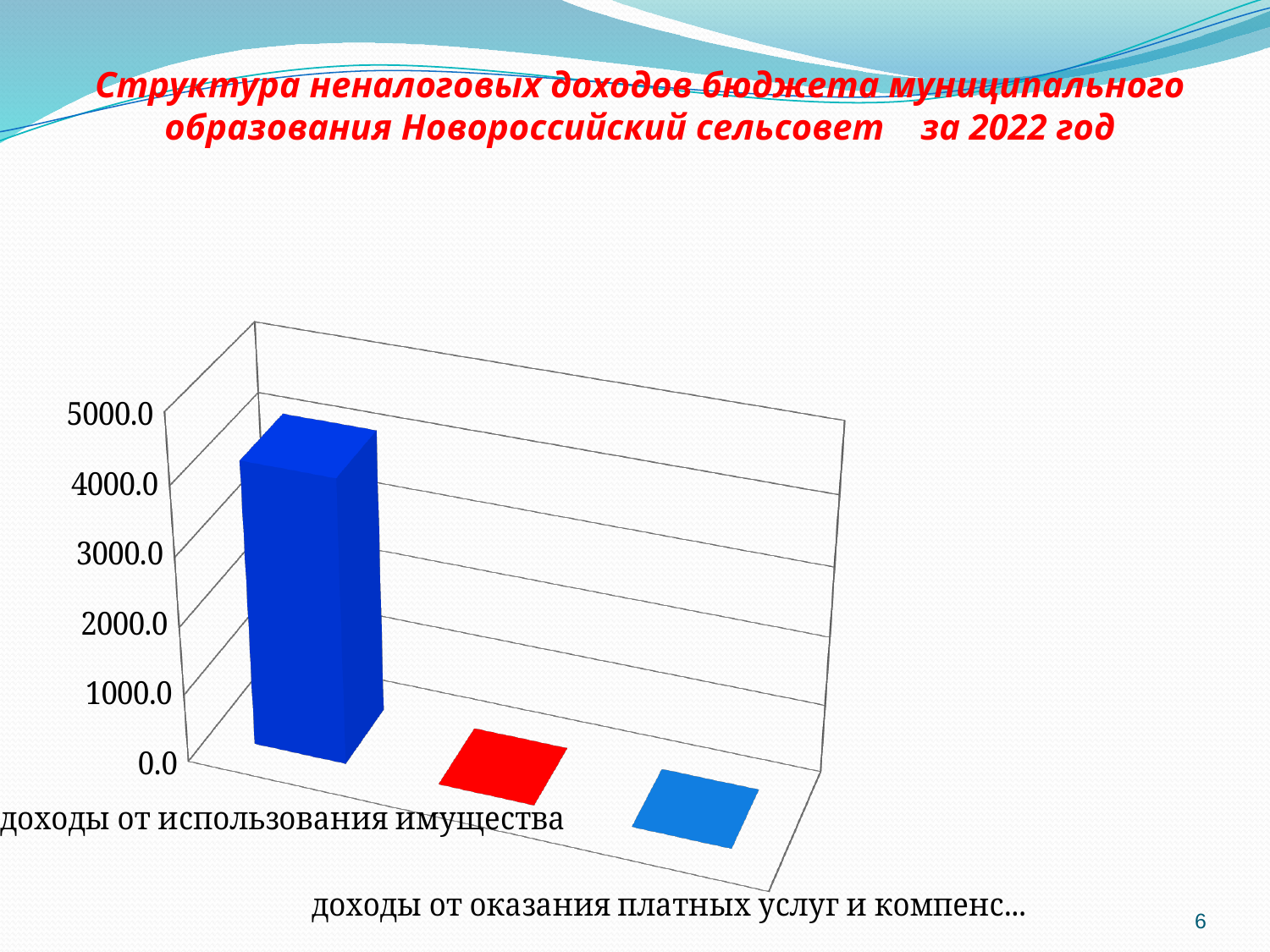
Is the value for доходы от оказания платных услуг и компенс... greater or less than 1000.0? less What is the highest value shown on the vertical axis of the chart? 5000.0 Which is larger: the value for доходы от использования имущества or the value for доходы от оказания платных услуг и компенс...? доходы от использования имущества Which category has the highest value in the chart? доходы от использования имущества How many bars are plotted in the chart? 3 What kind of chart is shown on the slide? bar chart Is the value for доходы от использования имущества greater or less than 5000.0? less Is the value for доходы от использования имущества greater or less than 3000.0? greater What year does the chart title say the data is for? 2022